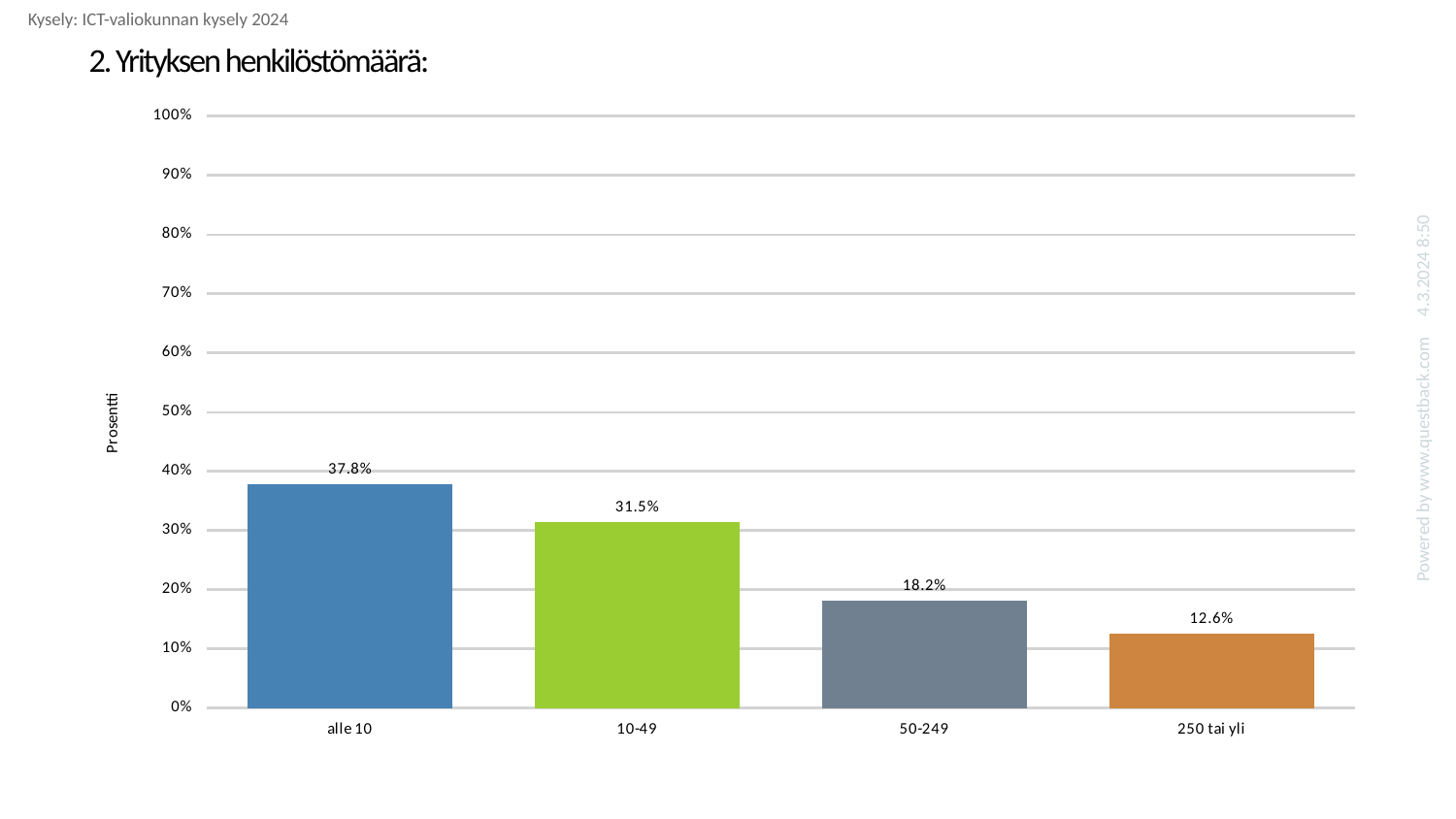
Which category has the lowest value? 250 tai yli What kind of chart is shown on the slide? bar chart What is the label of the y axis? Prosentti What is the difference between the values for 'alle 10' and '10-49'? 6.3% Which is larger, the value for '50-249' or the value for '250 tai yli'? 50-249 How many categories are shown on the x axis? 4 Is the value for '10-49' greater or less than 30%? greater What is the value for the 'alle 10' category? 37.8% What is the value for the '250 tai yli' category? 12.6% What is the value for the '10-49' category? 31.5% What is the value for the '50-249' category? 18.2% Which category has the highest value? alle 10